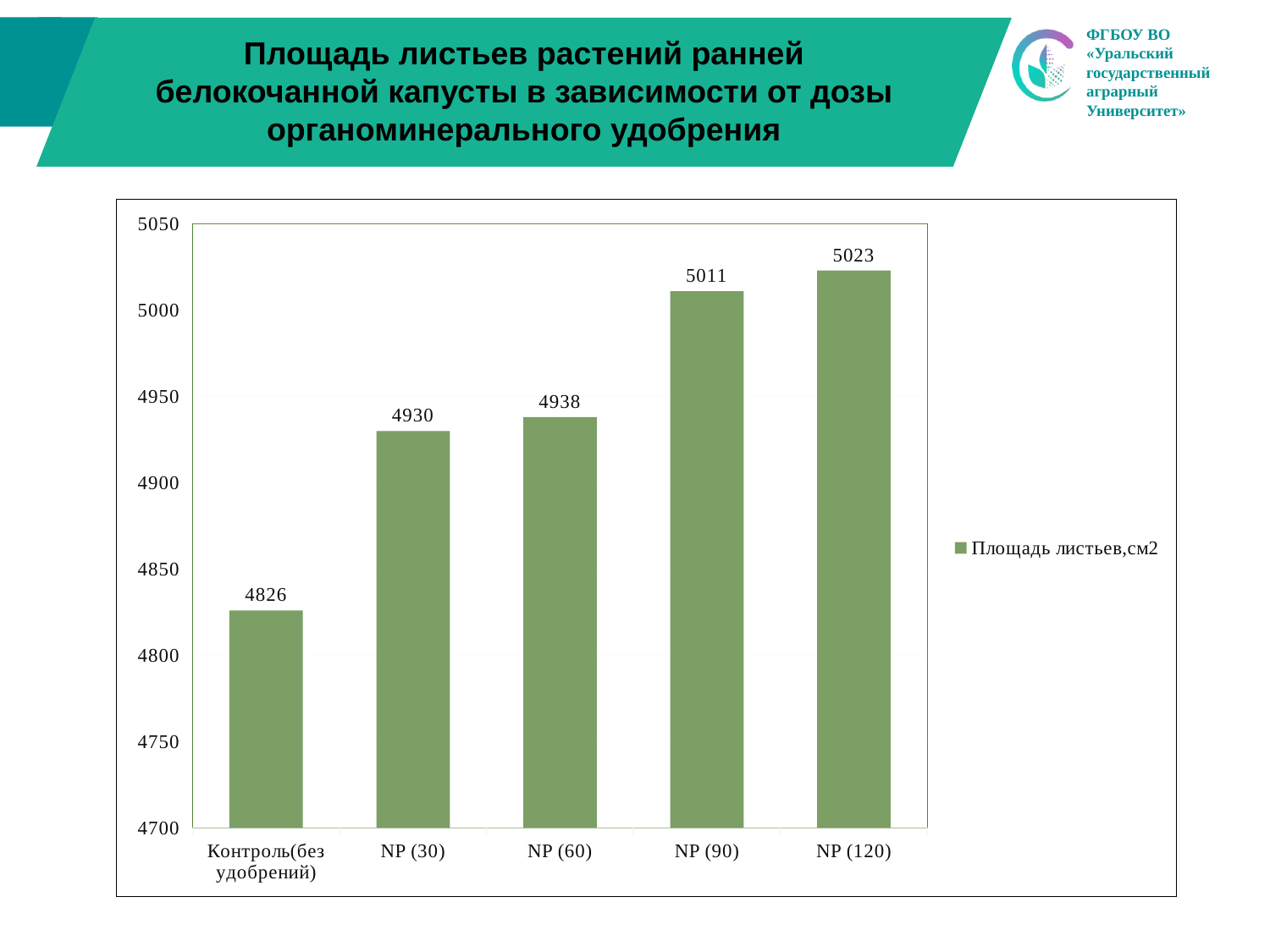
Which category has the highest leaf area? NP (120) What is the leaf area value for NP (90)? 5011 What is the value shown for NP (60)? 4938 What is the difference between the values for NP (60) and NP (30)? 8 Which is larger, the value for NP (90) or the value for NP (30)? NP (90) Is the value for NP (30) greater or less than 4900? greater How many categories are shown on the x axis? 5 What kind of chart is shown on the slide? bar chart What is the difference between the values for NP (120) and Контроль(без удобрений)? 197 Do the values rise or fall from left to right along the x axis? rise Which category has the lowest leaf area? Контроль(без удобрений) What is the leaf area value for Контроль(без удобрений)? 4826